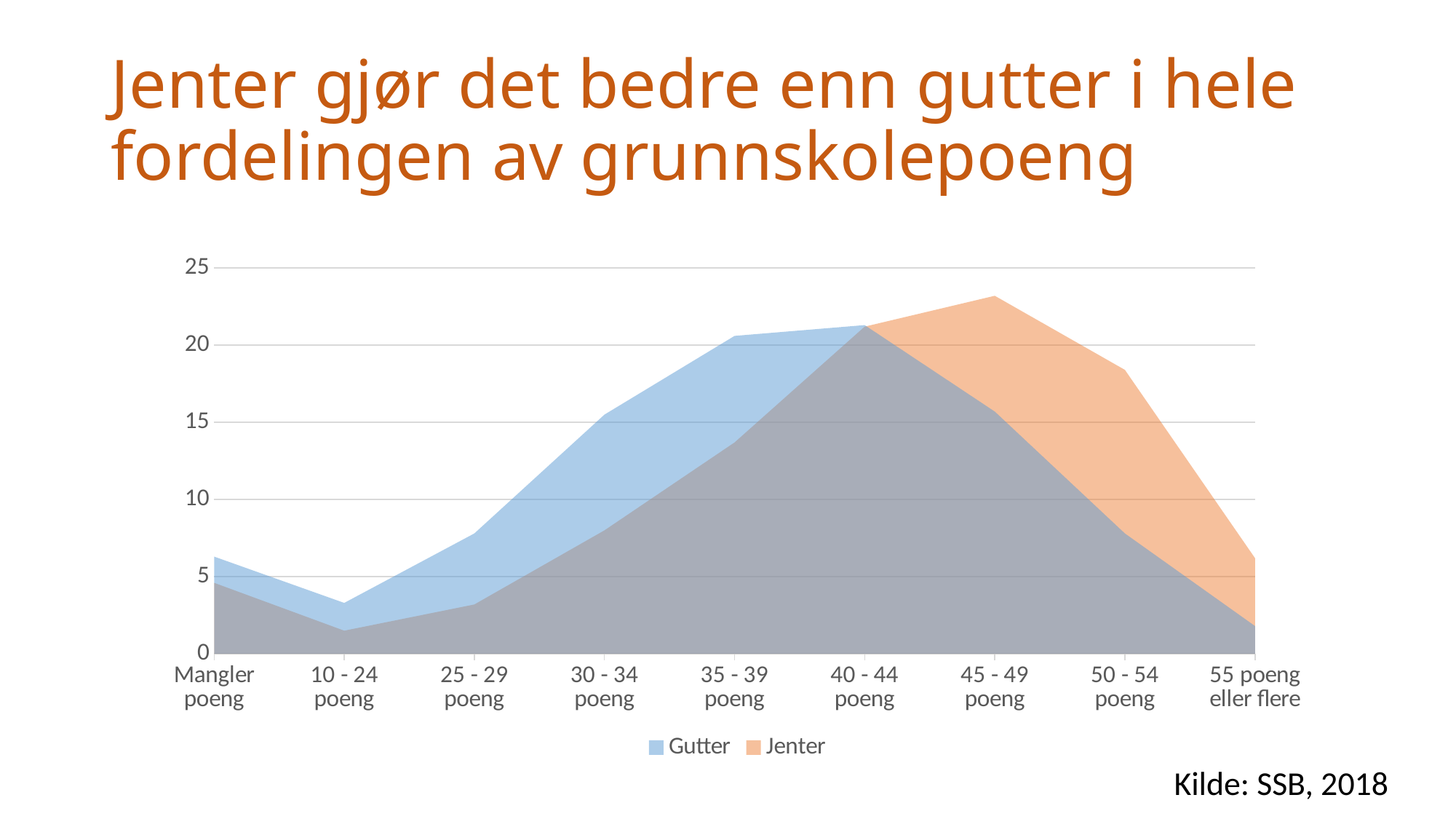
Which category has the lowest value for Jenter? 10 - 24 poeng Is the value for Jenter at 50 - 54 poeng greater or less than 15? greater Which category has the lowest value for Gutter? 55 poeng eller flere Which category has the highest value for Jenter? 45 - 49 poeng How many series does the legend list? 2 At 30 - 34 poeng, which series has the larger value, Gutter or Jenter? Gutter At 50 - 54 poeng, which series has the larger value, Gutter or Jenter? Jenter How many categories are shown along the x axis? 9 What kind of chart is shown on the slide? Area chart Do the values for Jenter rise or fall from 45 - 49 poeng to 55 poeng eller flere? fall Is the value for Jenter at 45 - 49 poeng greater or less than 20? greater Is the value for Gutter at 25 - 29 poeng greater or less than 10? less